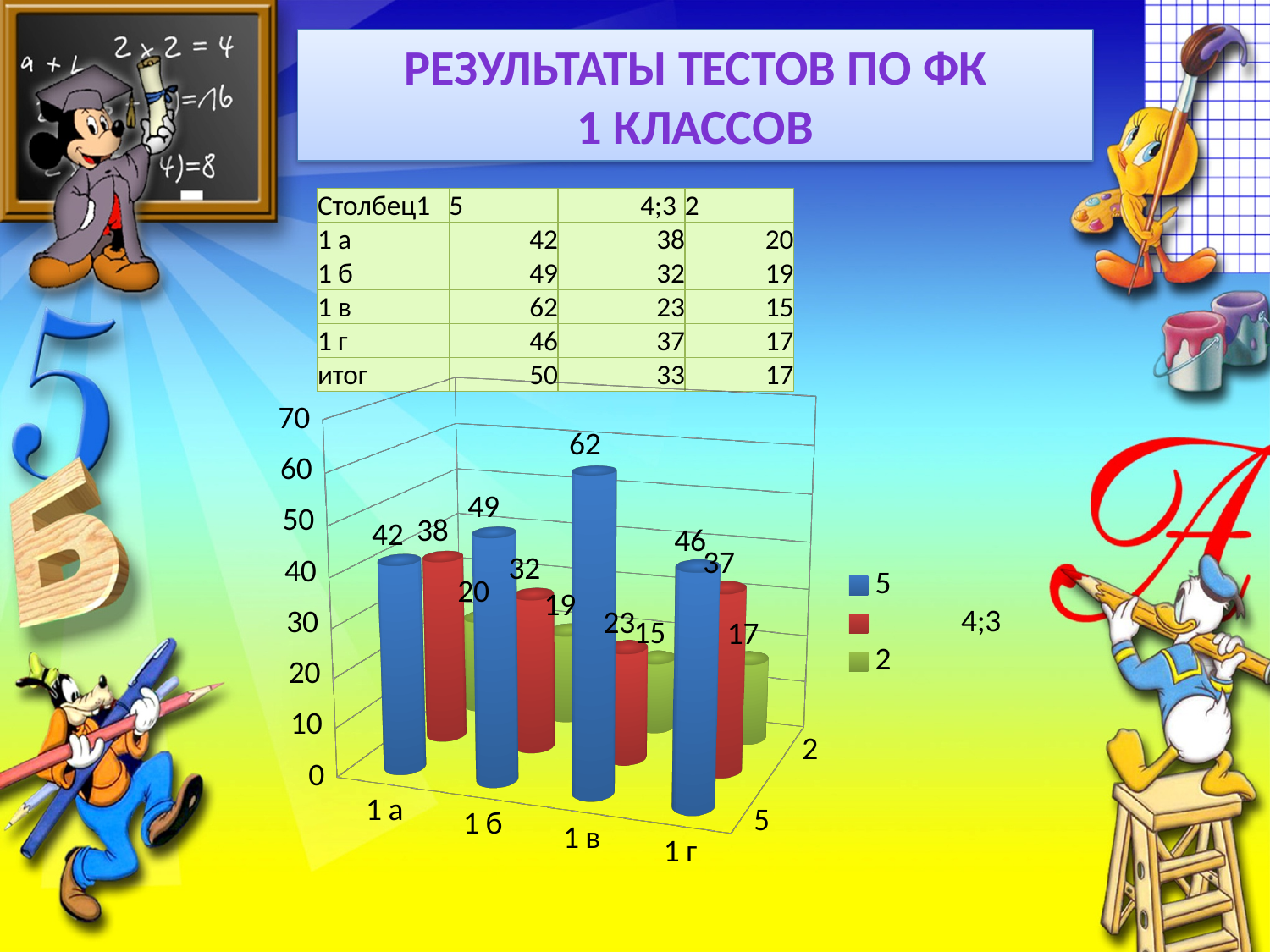
Which category has the highest value in series "5"? 1 в What is the difference between the series "5" values for "1 в" and "1 а"? 20 Which is larger: the series "4;3" value for "1 г" or for "1 б"? 1 г How many series does the chart legend list? 3 How many categories are shown on the x axis of the chart? 4 What is the value of series "5" for category "1 в"? 62 What type of chart is shown on the slide? bar chart What is the value of series "4;3" for category "1 а"? 38 Is the value of series "5" for "1 б" greater or less than 40? greater What is the value of series "2" for category "1 б"? 19 Which category has the lowest value in series "2"? 1 в What colour represents series "5" in the chart? blue